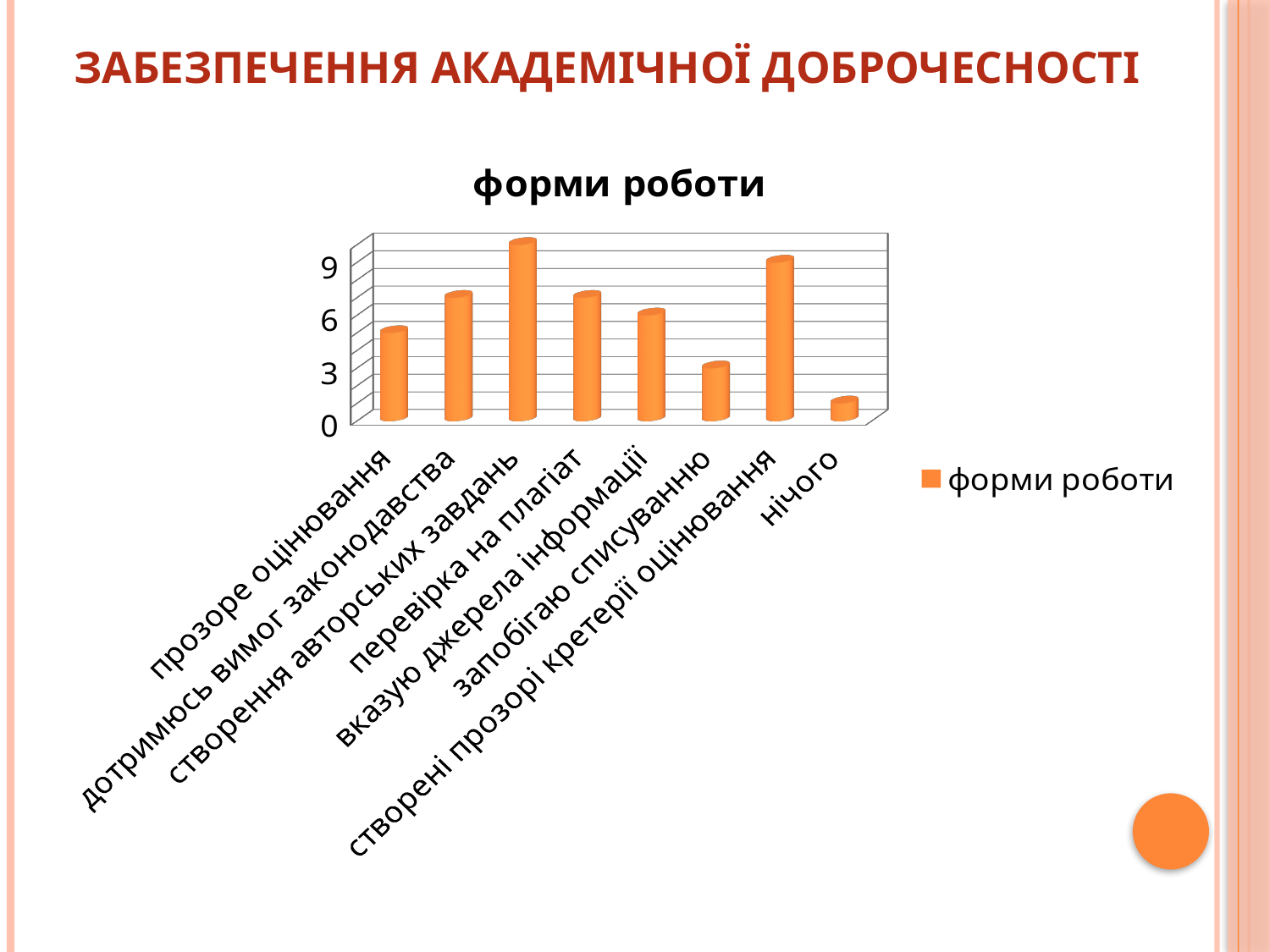
Which category has the highest bar? створення авторських завдань Is the value for створені прозорі кретерії оцінювання greater or less than 6? greater Is the value for створення авторських завдань greater or less than 9? greater How many categories are shown on the x axis of the chart? 8 Is the value for запобігаю списуванню greater or less than 6? less Which category has the lowest bar? нічого How many series does the legend list? 1 What kind of chart is shown on the slide? bar chart Which is larger, the value for дотримуюсь вимог законодавства or the value for запобігаю списуванню? дотримюсь вимог законодавства Which is larger, the value for вказую джерела інформації or the value for створені прозорі кретерії оцінювання? створені прозорі кретерії оцінювання What is the title of the chart? форми роботи